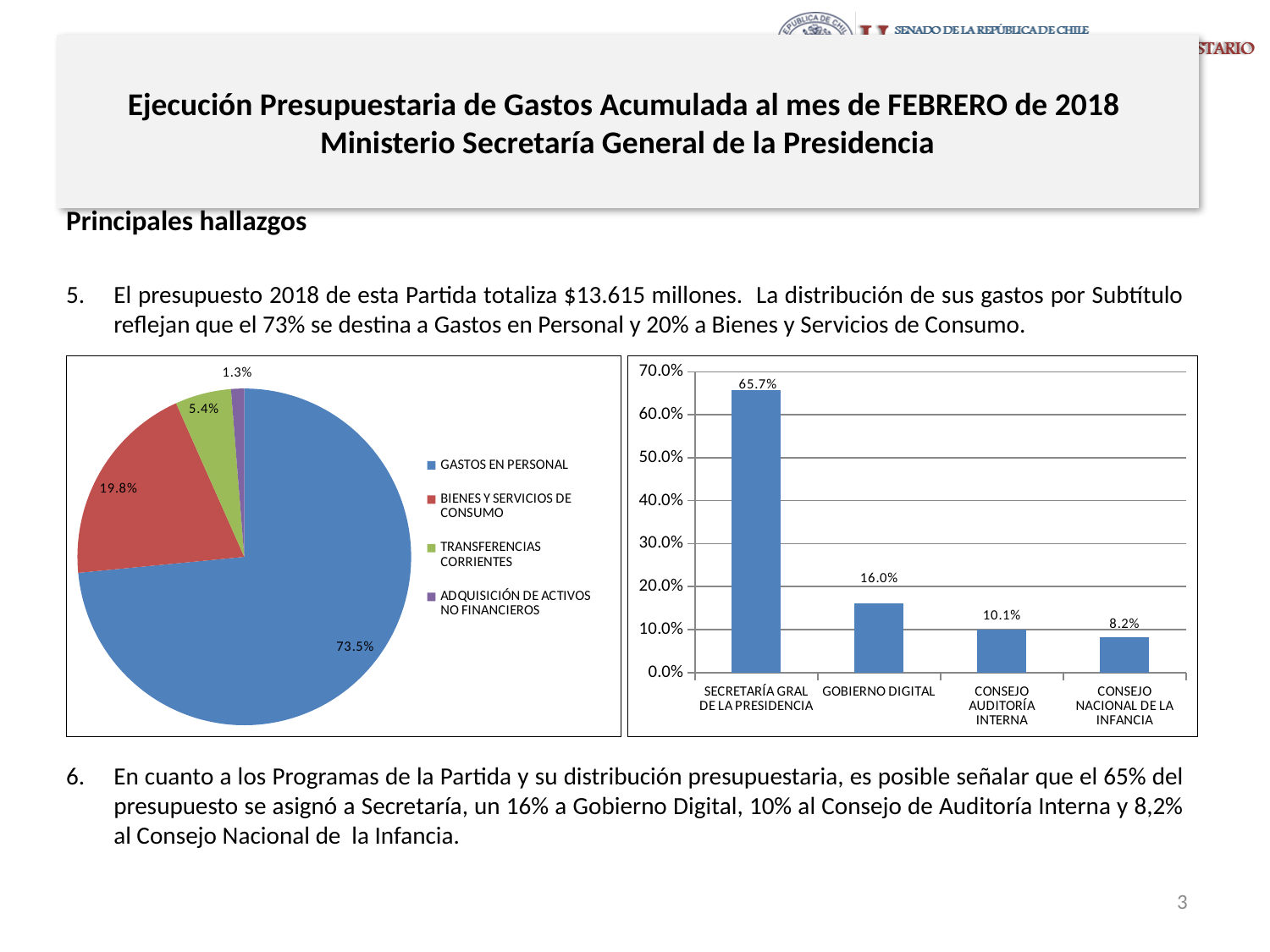
In the bar chart on the right, do the values rise or fall from left to right? Fall In the bar chart on the right, how many categories are shown on the x axis? 4 In the bar chart on the right, which category has the highest value? SECRETARÍA GRAL DE LA PRESIDENCIA In the pie chart on the left, what share does GASTOS EN PERSONAL have? 73.5% In the pie chart on the left, how many slices are there? 4 In the bar chart on the right, what is the difference between CONSEJO AUDITORÍA INTERNA and CONSEJO NACIONAL DE LA INFANCIA? 1.9% In the bar chart on the right, what is the value for GOBIERNO DIGITAL? 16.0% In the pie chart on the left, which category has the smallest slice? ADQUISICIÓN DE ACTIVOS NO FINANCIEROS What type of chart is shown on the right side of the slide? Bar chart In the pie chart on the left, what is the difference between GASTOS EN PERSONAL and BIENES Y SERVICIOS DE CONSUMO? 53.7% In the pie chart on the left, which is larger: TRANSFERENCIAS CORRIENTES or ADQUISICIÓN DE ACTIVOS NO FINANCIEROS? TRANSFERENCIAS CORRIENTES In the pie chart on the left, what is the value for BIENES Y SERVICIOS DE CONSUMO? 19.8%